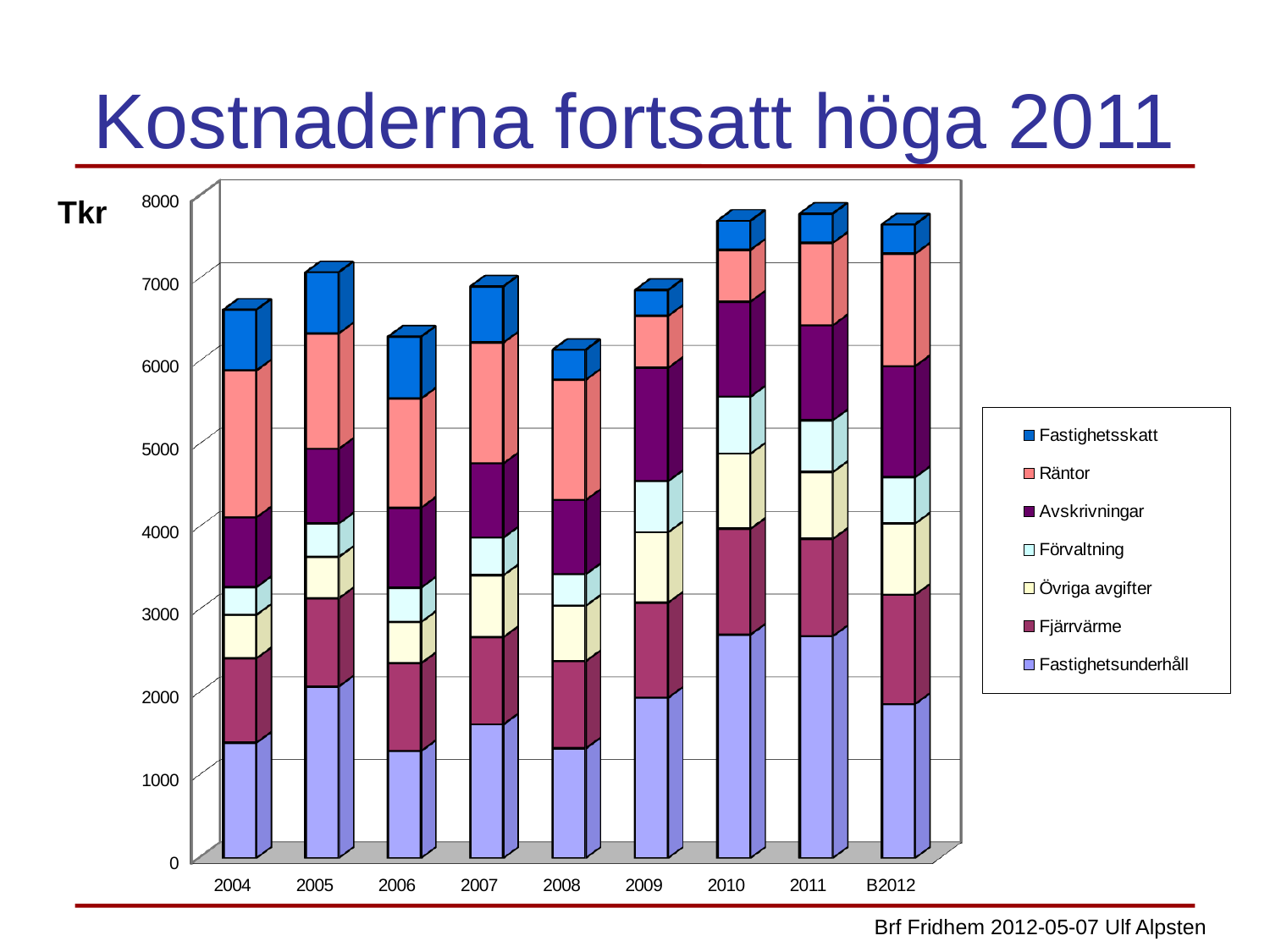
Is the total of the stacked bar for 2004 greater or less than 7000? less How many series does the chart's legend list? 7 Is the Fastighetsunderhåll value for 2010 greater or less than 2000? greater Which year has the larger Fastighetsunderhåll value, 2004 or 2011? 2011 Which year has the larger total stacked bar, 2008 or 2010? 2010 Is the total of the stacked bar for 2008 greater or less than 7000? less What is the title of the slide containing the chart? Kostnaderna fortsatt höga 2011 What kind of chart is shown on the slide? Stacked bar chart How many years (categories) are shown on the x axis of the chart? 9 What unit label is shown next to the y axis of the chart? Tkr